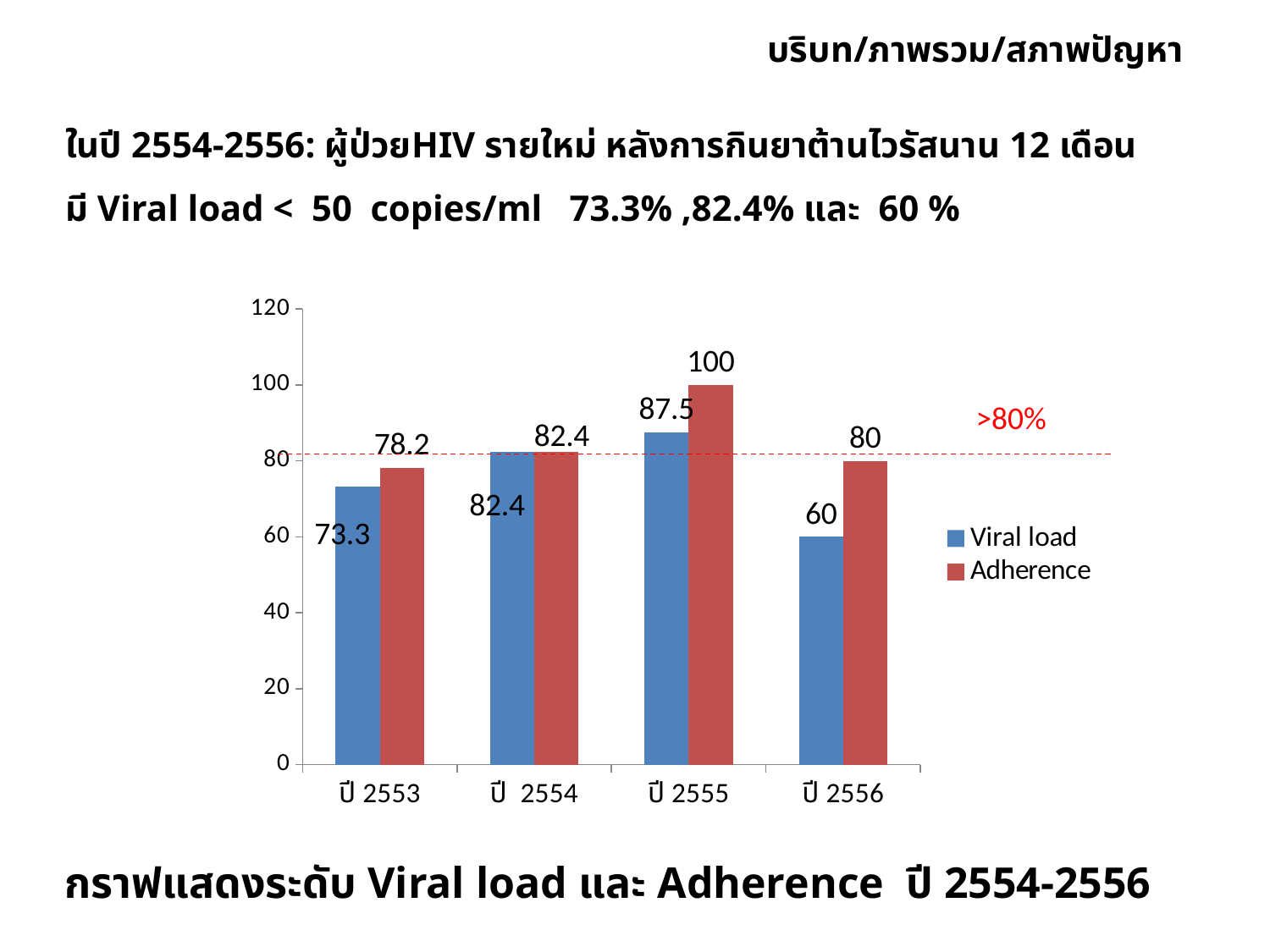
What is the Adherence value for ปี 2555? 100 What is the Viral load value for ปี 2553? 73.3 Which year has the highest Viral load value? ปี 2555 Is the Viral load value for ปี 2556 greater or less than 80? less How many series does the legend list? 2 What kind of chart is shown on the slide? bar chart How many years are shown on the x axis? 4 What is the difference between the Adherence and Viral load values for ปี 2555? 12.5 What is the Adherence value for ปี 2553? 78.2 What is the Viral load value for ปี 2556? 60 Which year has the lowest Adherence value? ปี 2553 Which is larger for ปี 2556, the Viral load value or the Adherence value? Adherence